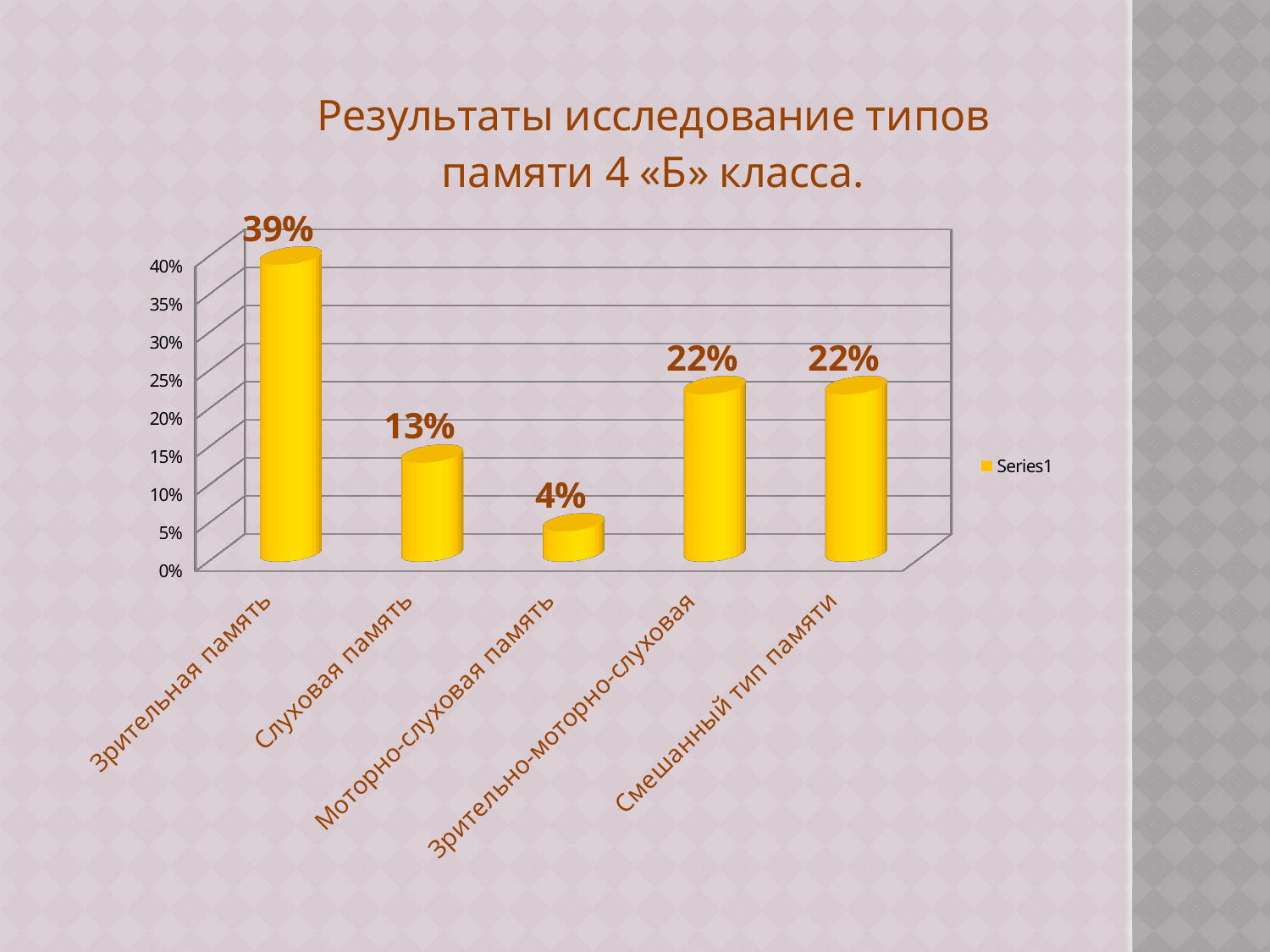
What is the value for Слуховая память? 13% Which memory type has the lowest value? Моторно-слуховая память What is the value for Смешанный тип памяти? 22% What is the value for Моторно-слуховая память? 4% Which is larger, the value for Слуховая память or the value for Зрительно-моторно-слуховая? Зрительно-моторно-слуховая What is the difference between the values for Зрительная память and Слуховая память? 26% How many categories are shown on the x axis? 5 What is the value for Зрительная память? 39% What is the name of the series shown in the legend? Series1 Which memory type has the highest value? Зрительная память How many series does the legend list? 1 What kind of chart is shown on the slide? Bar chart